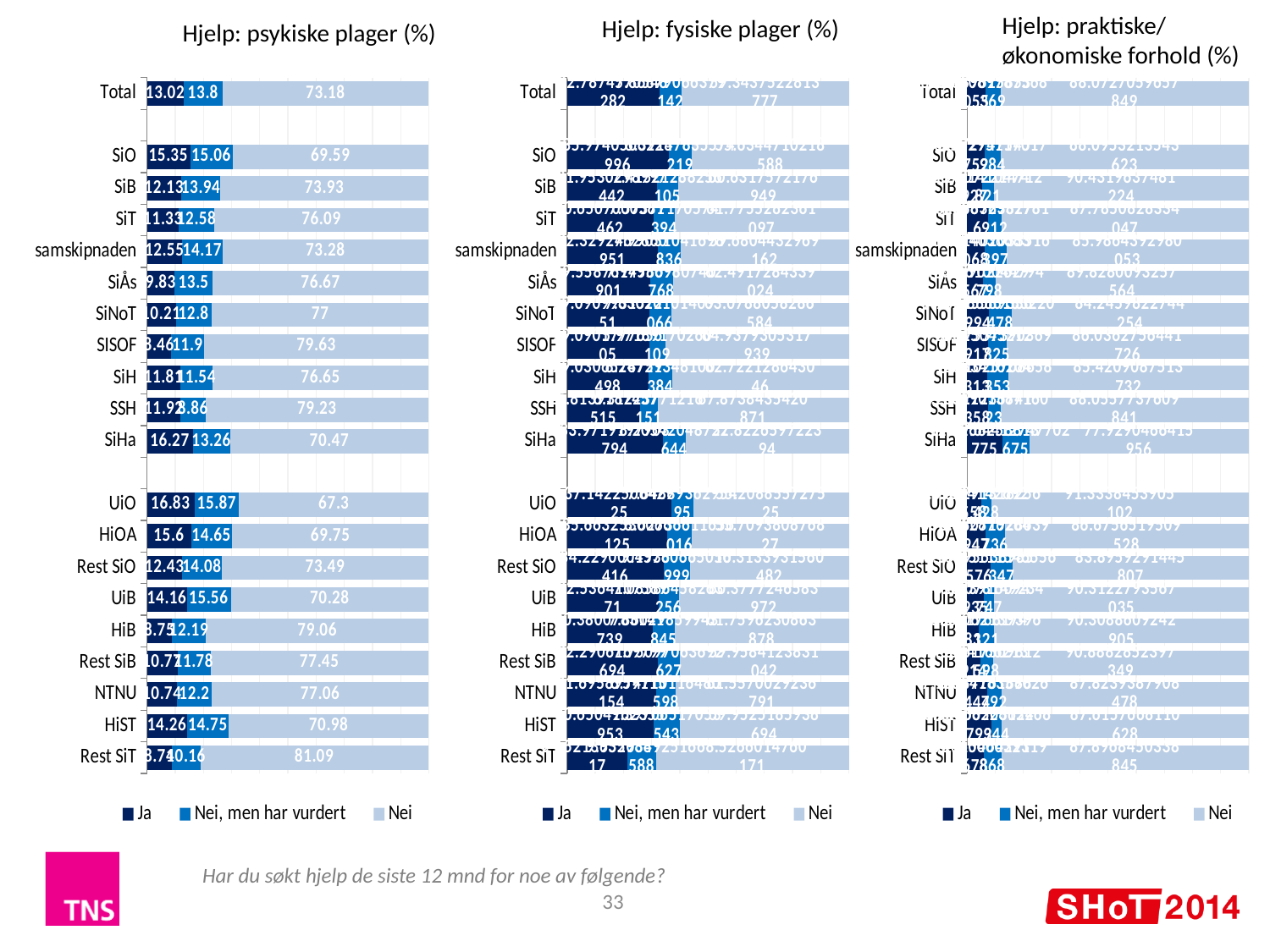
In the chart titled "Hjelp: psykiske plager (%)", what is the difference between the "Nei" values for Rest SiT and UiO? 13.79 In the chart titled "Hjelp: psykiske plager (%)", what is the total of the three segments for Total? 100 In the chart titled "Hjelp: psykiske plager (%)", what is the "Nei" value for Rest SiT? 81.09 In the chart titled "Hjelp: psykiske plager (%)", what is the "Nei" value for Total? 73.18 In the chart titled "Hjelp: psykiske plager (%)", what is the "Nei, men har vurdert" value for SiO? 15.06 In the chart titled "Hjelp: psykiske plager (%)", is the "Ja" value larger for SiHa or for HiOA? SiHa What kind of chart is the chart titled "Hjelp: praktiske/økonomiske forhold (%)"? Stacked bar chart How many categories are plotted in the chart titled "Hjelp: psykiske plager (%)"? 20 In the chart titled "Hjelp: psykiske plager (%)", which category has the lowest "Nei" value? UiO In the chart titled "Hjelp: psykiske plager (%)", which category has the highest "Nei" value? Rest SiT In the chart titled "Hjelp: psykiske plager (%)", what is the "Ja" value for UiO? 16.83 How many series does the legend list in the chart titled "Hjelp: fysiske plager (%)"? 3